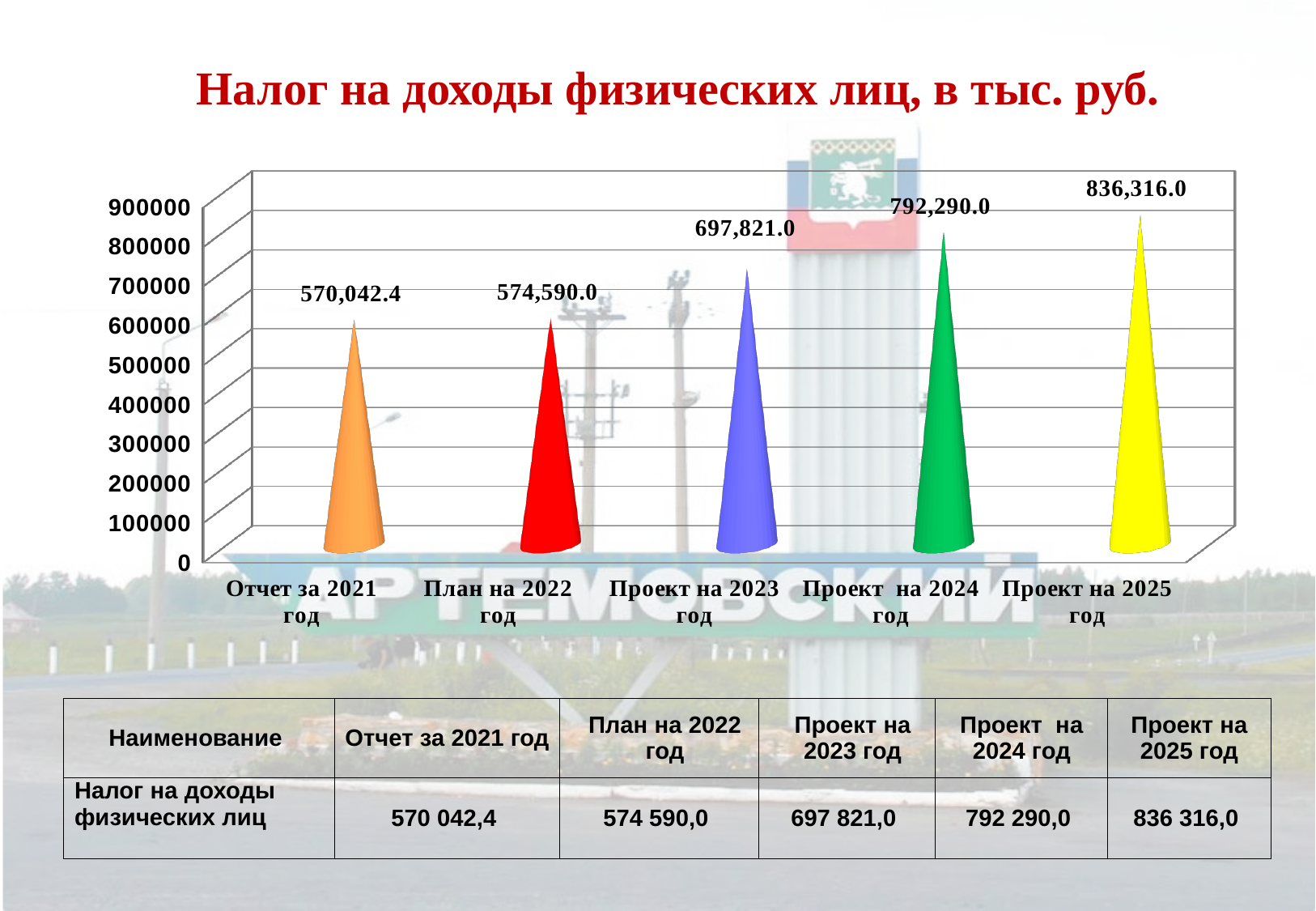
What kind of chart is shown on the slide? bar chart Which category has the lowest value? Отчет за 2021 год Is the value for «Проект на 2023 год» greater or less than 600000? greater What is the value for «Проект на 2025 год»? 836,316.0 How many categories are shown on the chart? 5 What is the value for «Отчет за 2021 год»? 570,042.4 Do the values rise or fall from «Отчет за 2021 год» to «Проект на 2025 год»? rise What is the difference between the values for «Проект на 2025 год» and «Отчет за 2021 год»? 266,273.6 Which category has the highest value? Проект на 2025 год Which is larger: the value for «План на 2022 год» or the value for «Проект на 2024 год»? Проект на 2024 год What is the value for «Проект на 2023 год»? 697,821.0 What is the difference between the values for «Проект на 2024 год» and «Проект на 2023 год»? 94,469.0